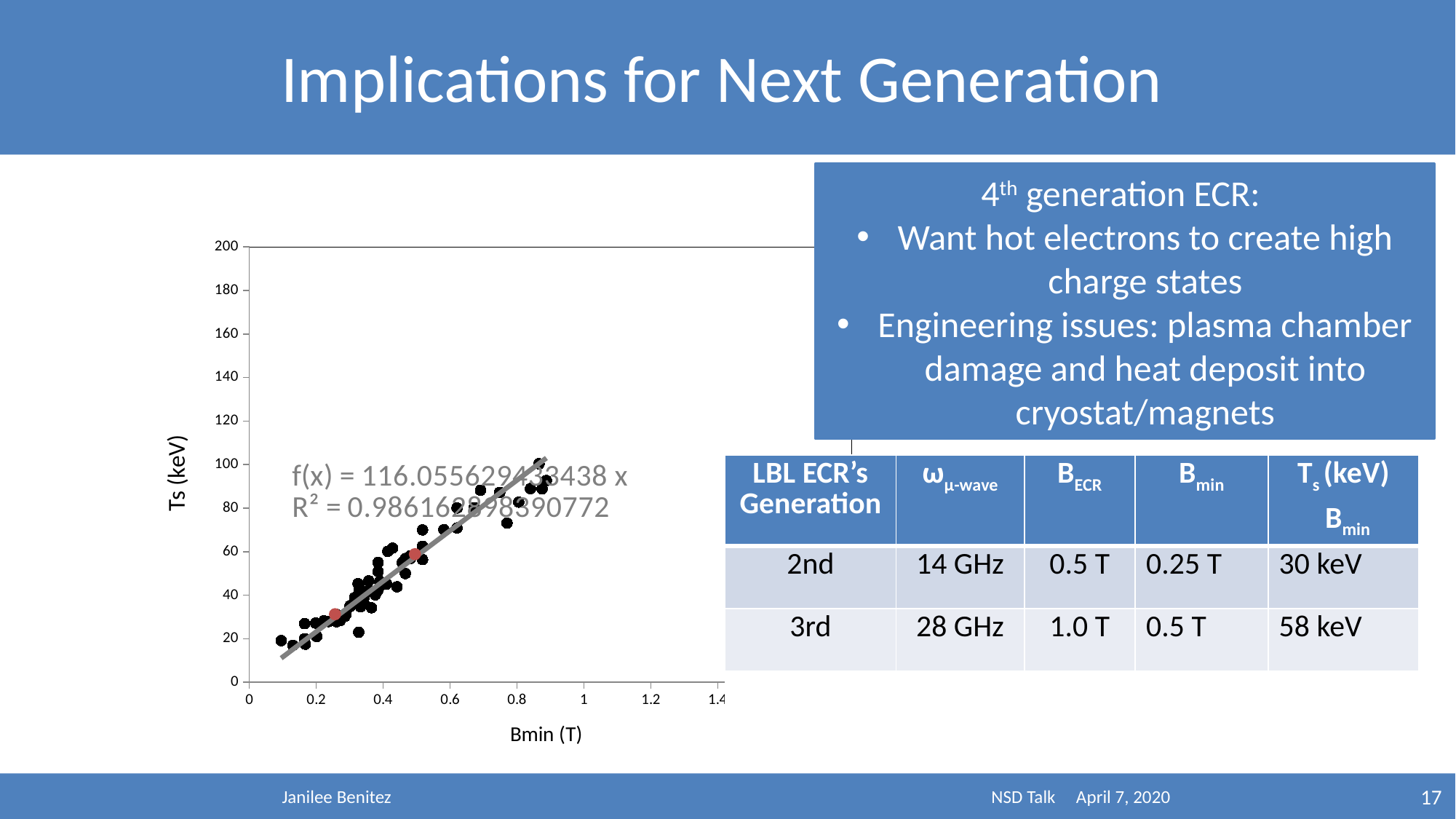
What is the maximum value shown on the y axis of the chart? 200 Is the Ts value of the highlighted red point at Bmin 0.25 T greater or less than 20 keV? greater Is the Ts value of the highlighted red point at Bmin 0.5 T greater or less than 40 keV? greater Is the Ts value of the highlighted red point at Bmin 0.25 T greater or less than 40 keV? less What is the title of the y axis of the chart? Ts (keV) Which of the two highlighted red points has the larger Ts value, the one at Bmin 0.25 T or the one at Bmin 0.5 T? the one at Bmin 0.5 T What is the title of the x axis of the chart? Bmin (T) What kind of chart is shown on the slide? scatter chart Do the Ts values rise or fall as Bmin increases along the x axis? rise